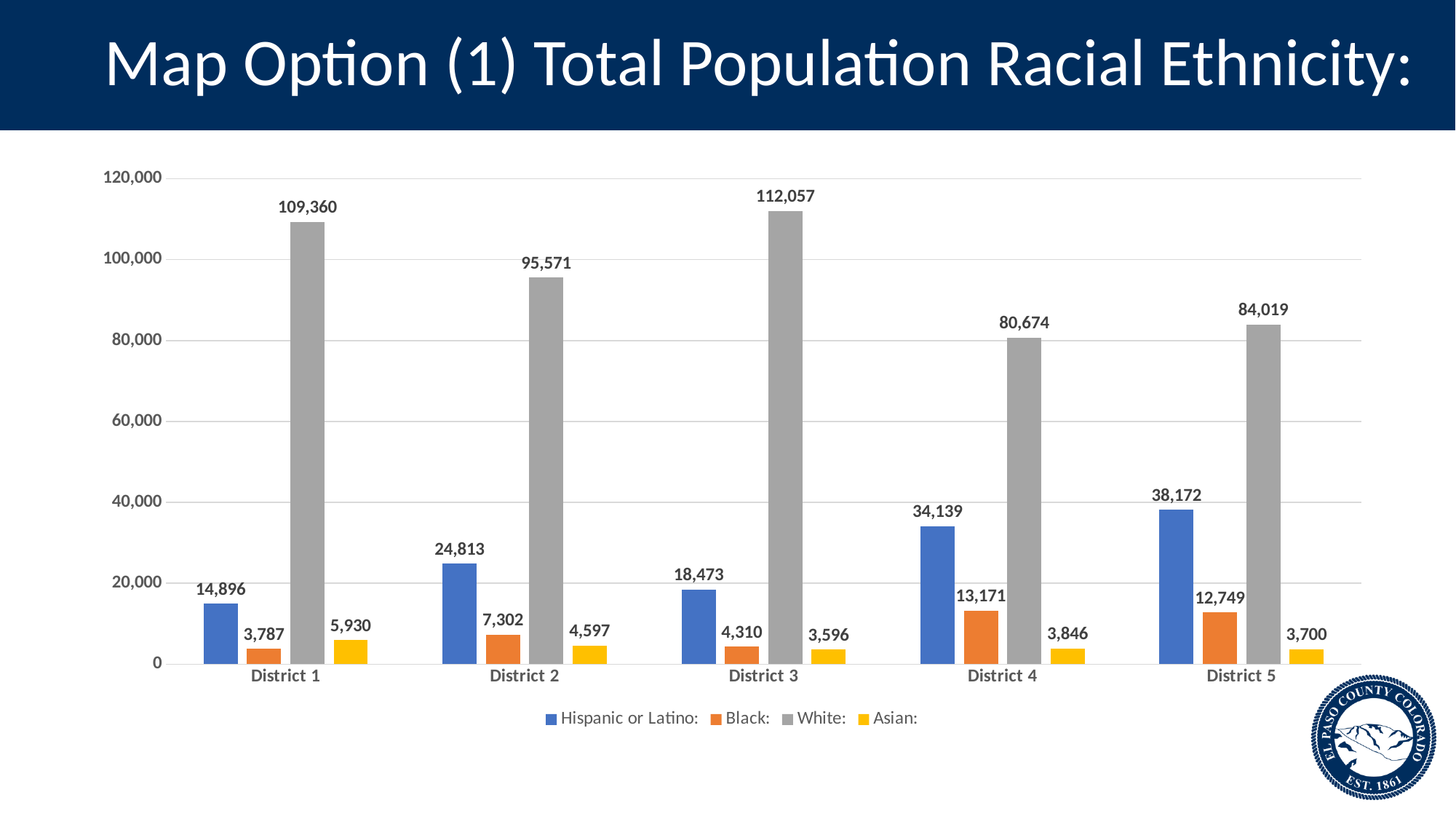
What is the Hispanic or Latino value for District 2? 24,813 What is the Asian value for District 5? 3,700 Which district has the lowest Asian value? District 3 Which district has the highest White value? District 3 Which district has the lowest Black value? District 1 What is the difference between the Hispanic or Latino values for District 5 and District 4? 4,033 What is the difference between the White values for District 3 and District 1? 2,697 How many districts are shown on the x axis? 5 What is the White population value for District 3? 112,057 What is the Black value for District 4? 13,171 How many series does the legend list? 4 Which is larger, the Black value for District 2 or the Asian value for District 1? Black value for District 2